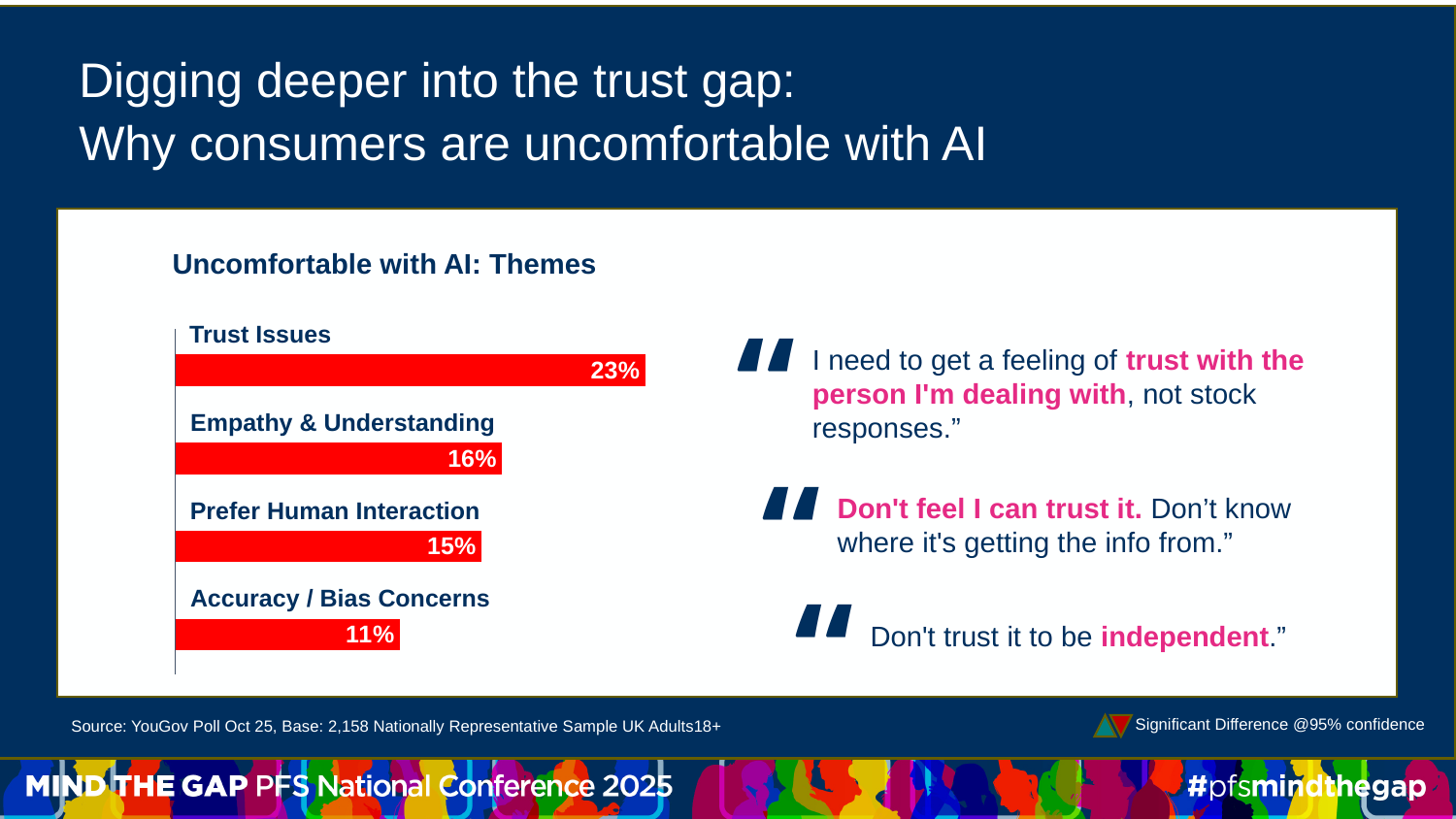
What percentage is shown for Trust Issues? 23% What kind of chart is used to show the themes? Bar chart What is the difference between the percentages for Empathy & Understanding and Prefer Human Interaction? 1% How many themes are shown in the chart? 4 What percentage is shown for Empathy & Understanding? 16% What is the difference between the percentages for Trust Issues and Accuracy / Bias Concerns? 12% What percentage is shown for Prefer Human Interaction? 15% Which is larger, the value for Trust Issues or the value for Empathy & Understanding? Trust Issues What is the title of the chart? Uncomfortable with AI: Themes Which theme has the lowest percentage? Accuracy / Bias Concerns Which theme has the highest percentage? Trust Issues What percentage is shown for Accuracy / Bias Concerns? 11%